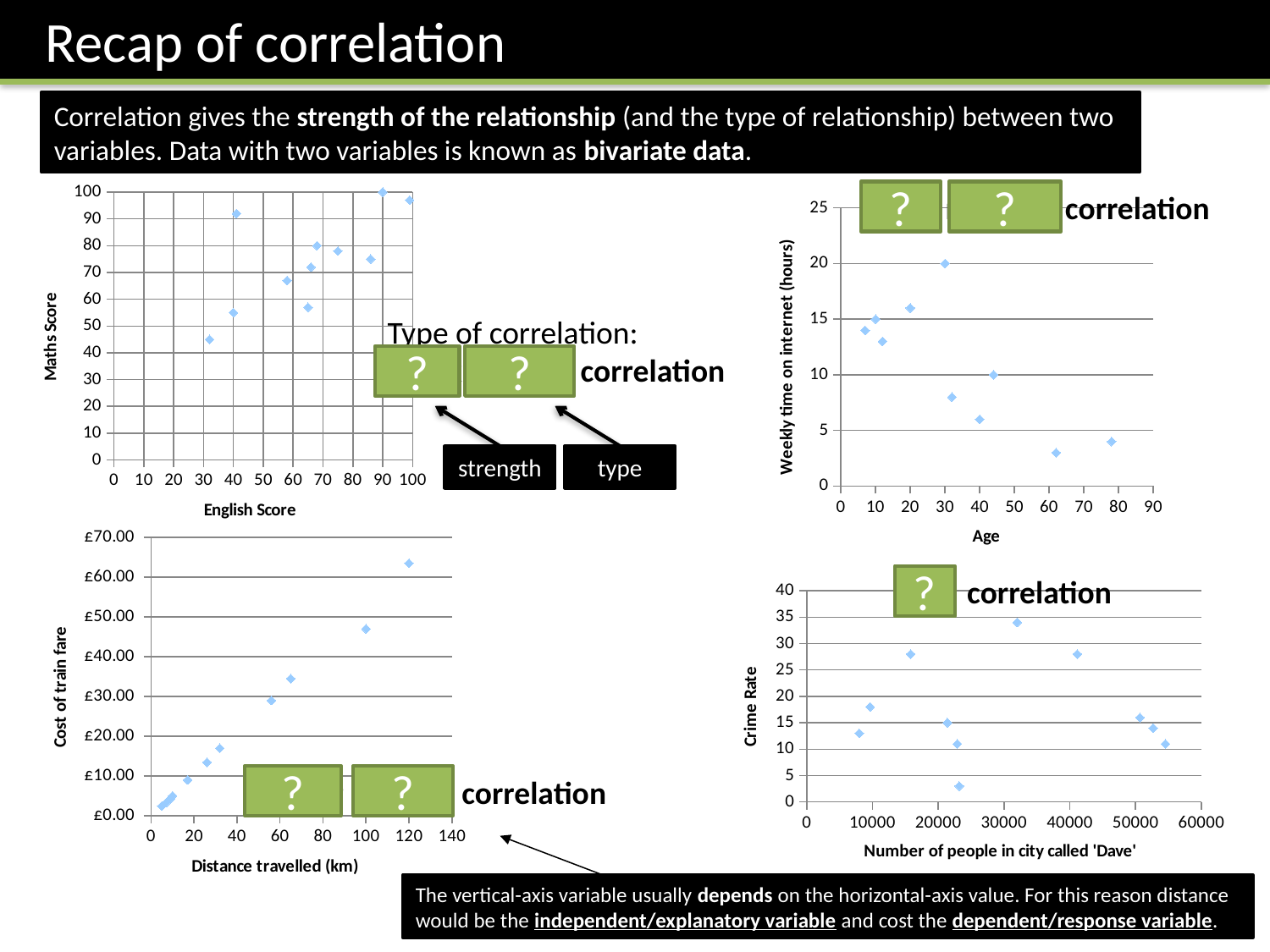
In the chart with the x-axis 'Number of people in city called 'Dave'', is the crime rate for the point at about 32000 people greater or less than 30? greater What is the label of the vertical axis on the chart with the x-axis 'Distance travelled (km)'? Cost of train fare What is the label of the vertical axis on the chart with the x-axis 'Number of people in city called 'Dave''? Crime Rate In the chart with the x-axis 'Age', how many data points are plotted? 10 In the chart with the x-axis 'Distance travelled (km)', is the cost for the point at 100 km greater or less than £50.00? less What kind of chart is the chart with the x-axis 'English Score'? scatter chart In the chart with the x-axis 'Age', is the weekly time on internet for the point at age 30 greater or less than 15? greater In the chart with the x-axis 'Age', do the weekly internet hours generally rise or fall as age increases? fall In the chart with the x-axis 'Distance travelled (km)', does the cost of train fare rise or fall as distance increases? rise In the chart with the x-axis 'English Score', do the Maths Score values generally rise or fall as English Score increases? rise